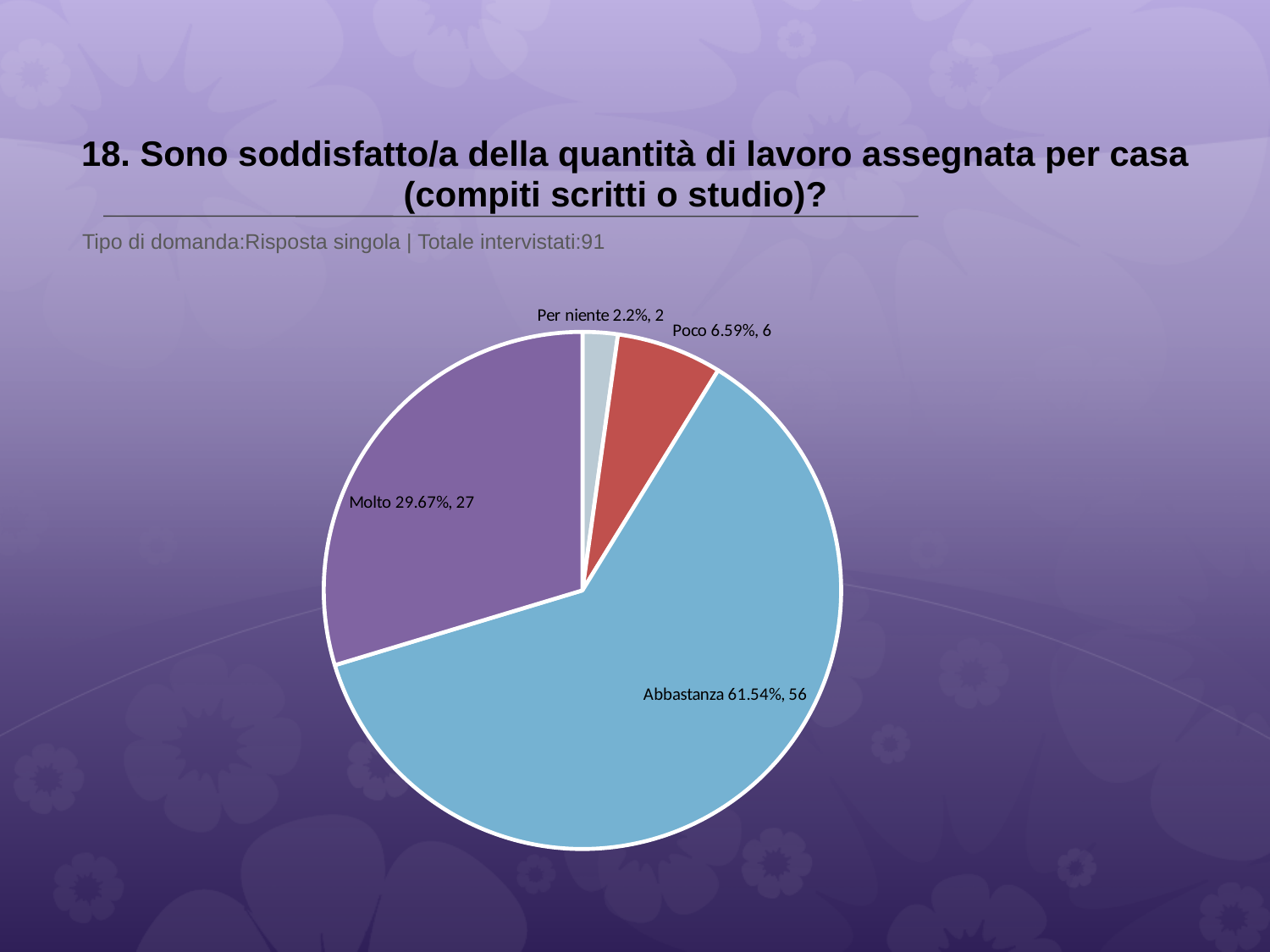
Which has more respondents, 'Poco' or 'Per niente'? Poco What percentage share does the 'Abbastanza' slice have? 61.54% What is the difference in respondent count between 'Abbastanza' and 'Molto'? 29 How many slices does the pie chart have? 4 Which category has the smallest slice? Per niente Which category has the largest slice? Abbastanza What percentage share does the 'Per niente' slice have? 2.2% How many respondents answered 'Molto'? 27 How many respondents answered 'Poco'? 6 What colour is the 'Abbastanza' slice? blue What is the total number of respondents shown in the subtitle? 91 What kind of chart is shown on the slide? pie chart